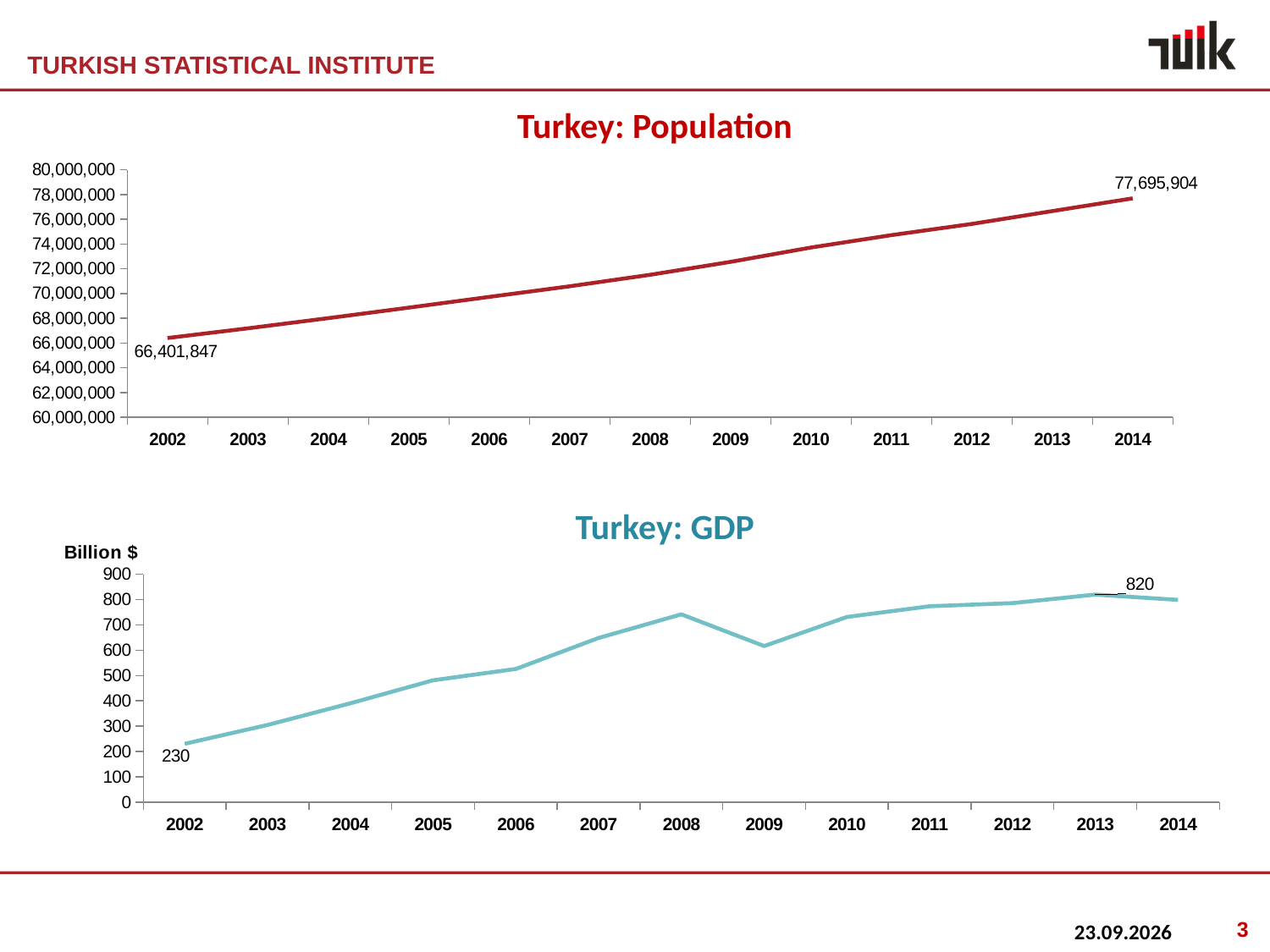
In the Turkey: GDP chart, what is the GDP value shown for 2013? 820 In the Turkey: GDP chart, what is the GDP value shown for 2002? 230 In the Turkey: Population chart, what is the population value shown for 2002? 66,401,847 In the Turkey: Population chart, does the population rise or fall from 2002 to 2014? rise In the Turkey: Population chart, how many years are shown on the x axis? 13 In the Turkey: GDP chart, is the value for 2009 greater or less than 700? less In the Turkey: GDP chart, what unit is given for the y axis? Billion $ In the Turkey: GDP chart, what is the difference between the 2013 value and the 2002 value? 590 In the Turkey: Population chart, by how much did the population increase from 2002 to 2014? 11,294,057 In the Turkey: Population chart, what is the population value shown for 2014? 77,695,904 In the Turkey: Population chart, is the value for 2008 greater or less than 70,000,000? greater What kind of chart is the Turkey: Population chart? line chart